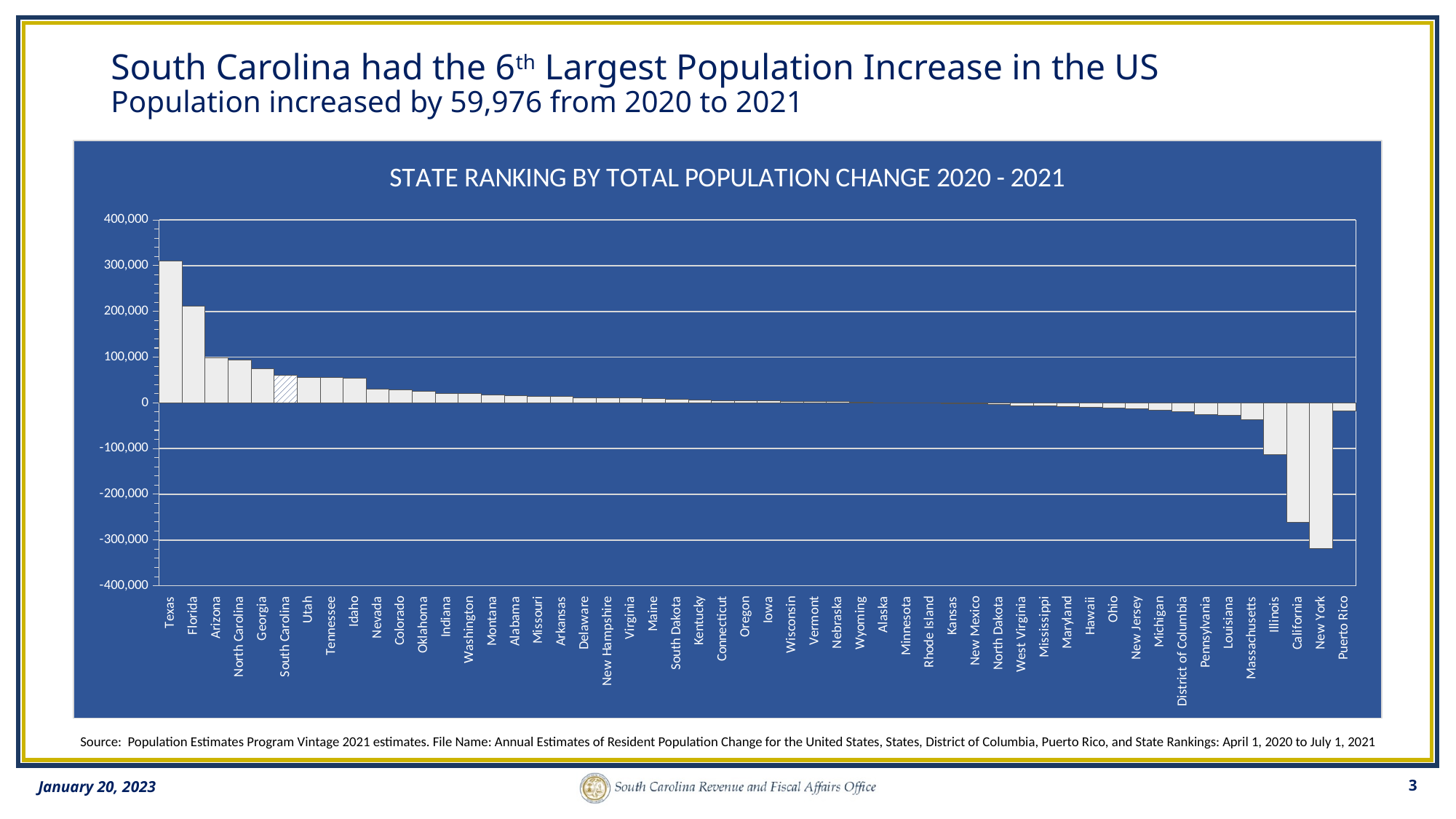
Is the value for Georgia greater or less than 100,000? less What was South Carolina's population increase from 2020 to 2021? 59,976 Which state has the lowest (most negative) total population change in the chart? New York Which state has the largest total population change in the chart? Texas How many states/territories are shown on the x axis of the chart? 52 Which has the larger population change, Florida or Arizona? Florida Do the values rise or fall moving from left to right along the x axis? Fall Is the value for Florida greater or less than 200,000? greater Is the value for California greater or less than -200,000? less What kind of chart is shown on the slide? Bar chart What is the title of the chart? STATE RANKING BY TOTAL POPULATION CHANGE 2020 - 2021